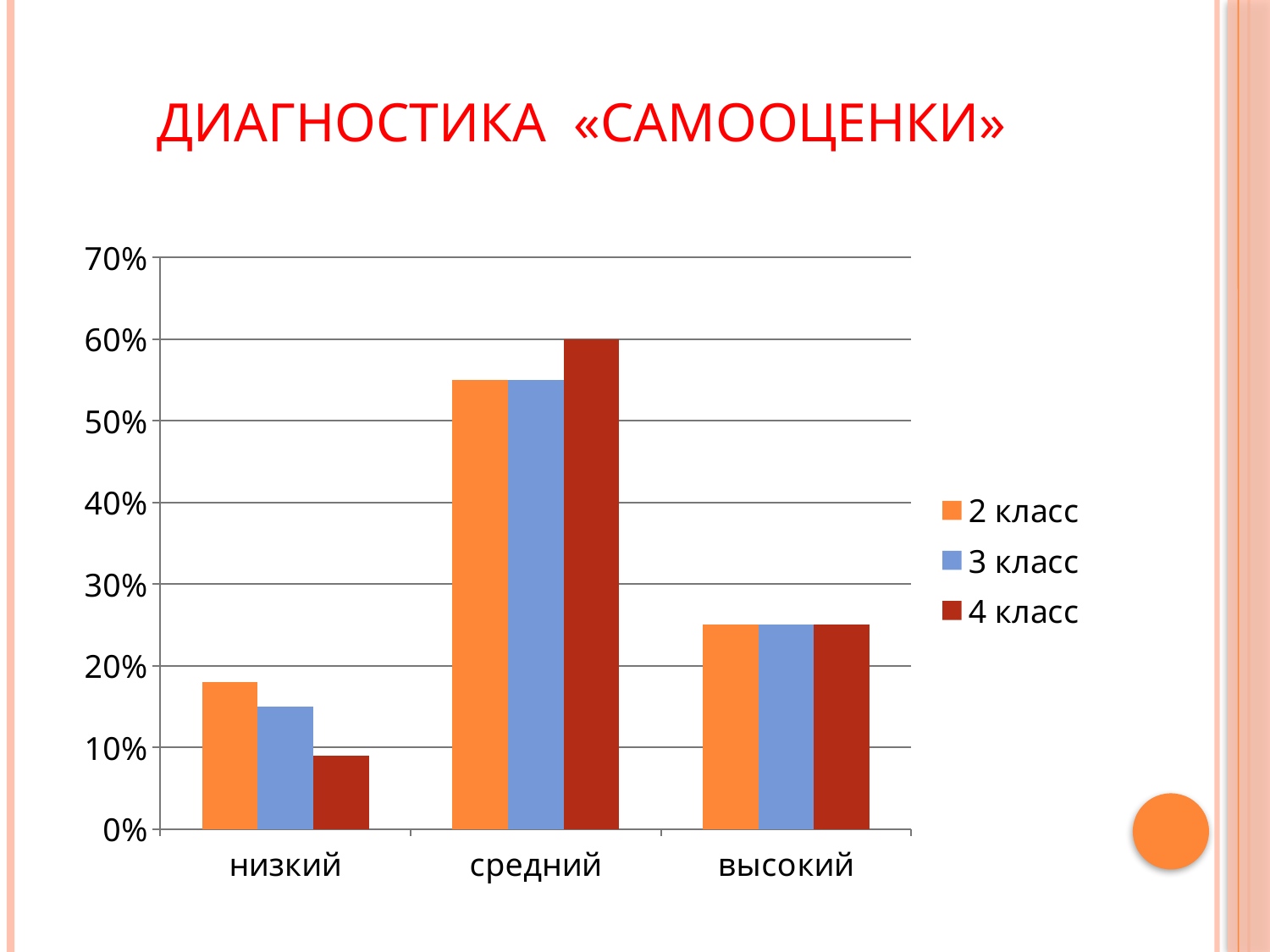
For the series 2 класс, which category has the highest value? средний How many series does the legend list? 3 Which series is shown in dark red in the legend? 4 класс How many categories are shown on the x axis? 3 In the category низкий, which is larger: the value for 2 класс or for 4 класс? 2 класс Is the value for 4 класс in the category низкий greater or less than 10%? less What kind of chart is shown on the slide? bar chart For the series 4 класс, which category has the lowest value? низкий Is the value for 2 класс in the category средний greater or less than 50%? greater In the category средний, which is larger: the value for 3 класс or for 4 класс? 4 класс What is the title of the slide? ДИАГНОСТИКА «САМООЦЕНКИ» Is the value for 3 класс in the category высокий greater or less than 30%? less